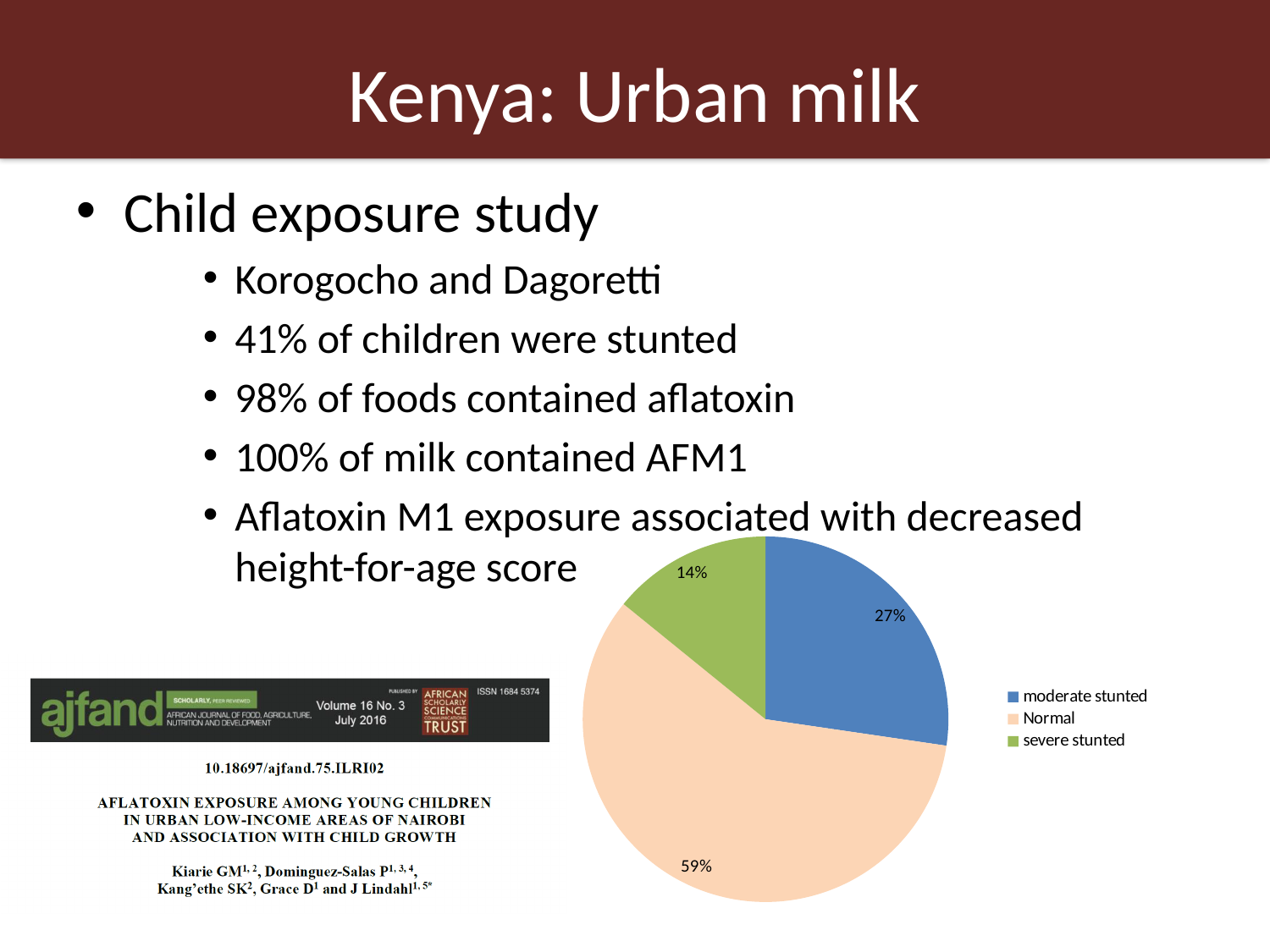
What kind of chart is shown on the slide? pie chart Which category has the smallest slice of the pie chart? severe stunted What is the difference in percentage points between the Normal slice and the moderate stunted slice? 32 How many categories does the pie chart show? 3 Which slice is larger, moderate stunted or severe stunted? moderate stunted Which category has the largest slice of the pie chart? Normal How many entries does the legend of the pie chart list? 3 What percentage of the pie chart is labelled Normal? 59% What percentage of the pie chart is labelled moderate stunted? 27% What percentage of the pie chart is labelled severe stunted? 14% What colour is the Normal slice in the pie chart? peach What is the combined percentage of the moderate stunted and severe stunted slices? 41%